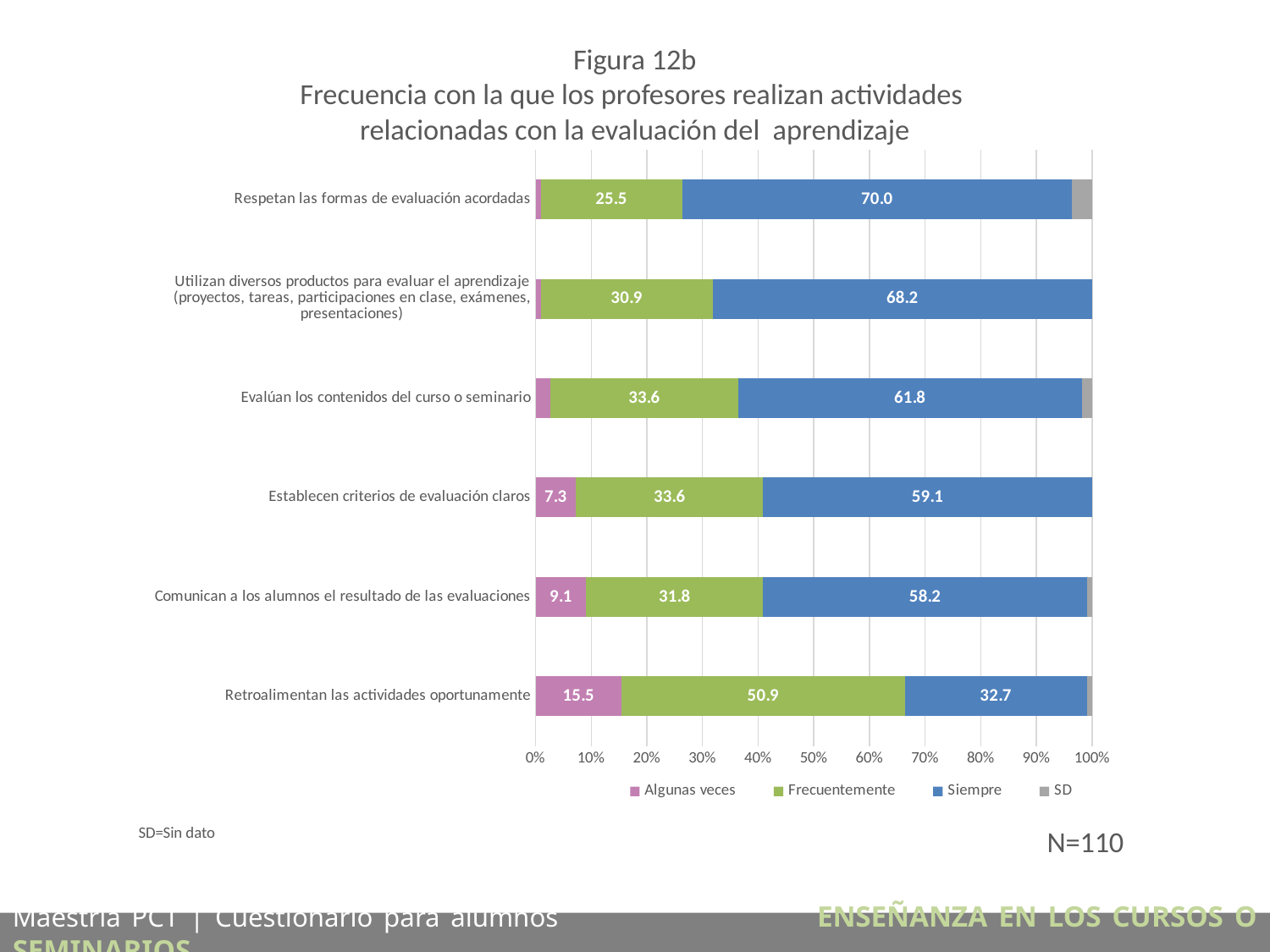
Is the 'Algunas veces' value for 'Retroalimentan las actividades oportunamente' greater or less than 10%? greater According to the note on the slide, what does 'SD' stand for? Sin dato Which is larger: the 'Frecuentemente' value for 'Utilizan diversos productos para evaluar el aprendizaje' or for 'Evalúan los contenidos del curso o seminario'? Evalúan los contenidos del curso o seminario Which category has the lowest 'Siempre' value? Retroalimentan las actividades oportunamente How many series does the legend list? 4 Which category has the highest 'Siempre' value? Respetan las formas de evaluación acordadas What is the 'Algunas veces' value for 'Comunican a los alumnos el resultado de las evaluaciones'? 9.1 What is the difference between the 'Siempre' and 'Frecuentemente' values for 'Respetan las formas de evaluación acordadas'? 44.5 What is the 'Frecuentemente' value for 'Retroalimentan las actividades oportunamente'? 50.9 What kind of chart is shown on the slide? Stacked bar chart What is the 'Siempre' value for 'Respetan las formas de evaluación acordadas'? 70.0 How many categories (activities) are shown on the chart? 6